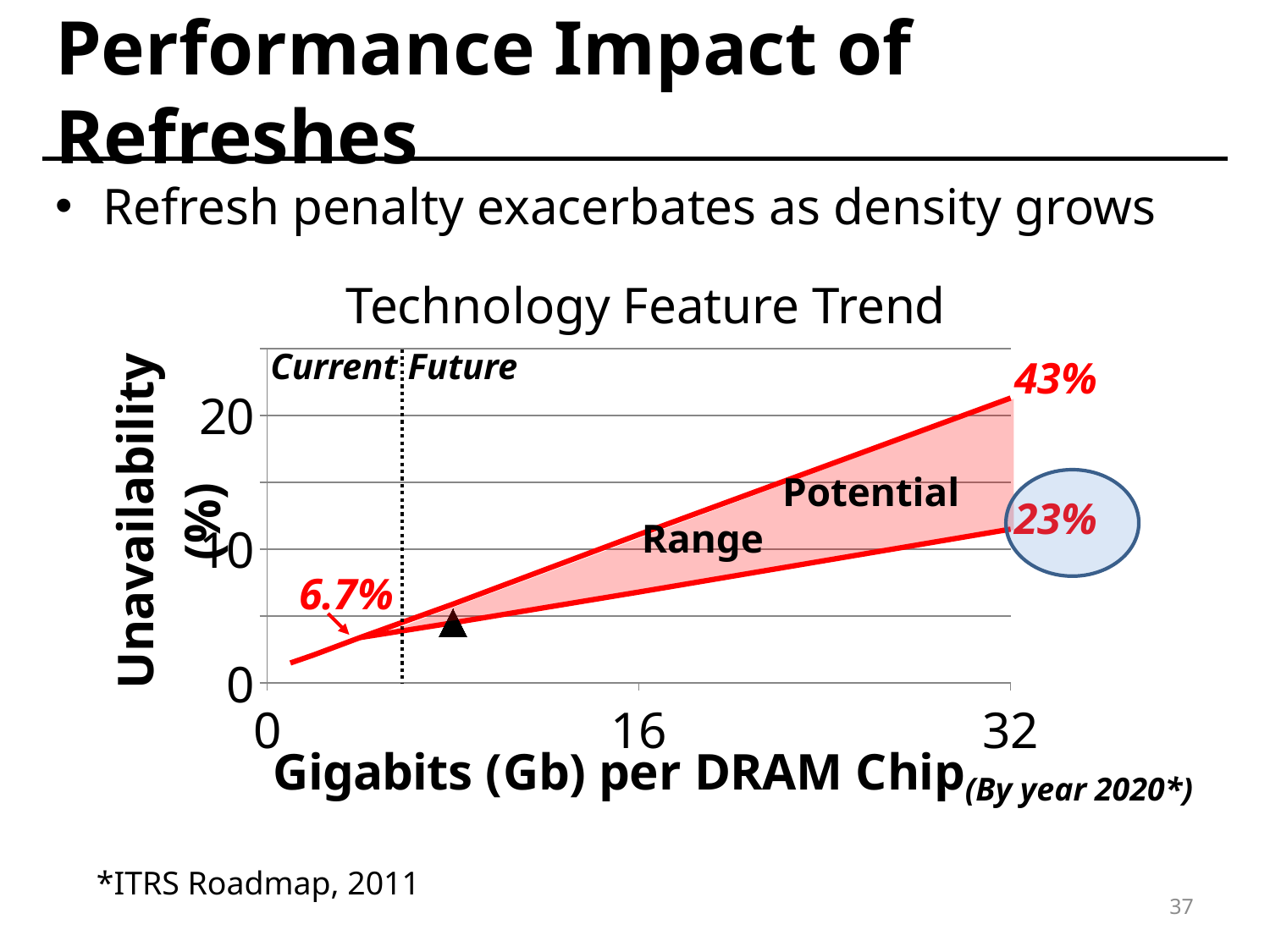
What unavailability percentage is labelled for the current DRAM chip density? 6.7% How many tick labels are shown on the x axis? 3 What is the title of the chart? Technology Feature Trend What kind of chart is shown on the slide? line chart Is the lower line of the potential range at 16 Gb greater or less than 10? less What label is given to the shaded region between the two lines? Potential Range Does unavailability rise or fall as gigabits per DRAM chip increase? rise What unavailability percentage is labelled at the bottom of the potential range at 32 Gb per DRAM chip? 23% What is the difference between the upper (43%) and lower (23%) unavailability labels at 32 Gb? 20 percentage points Which is larger at 32 Gb: the upper bound of the potential range or the lower bound? the upper bound (43%) What unavailability percentage is labelled at the top of the potential range at 32 Gb per DRAM chip? 43% What is the highest tick value shown on the y axis? 20